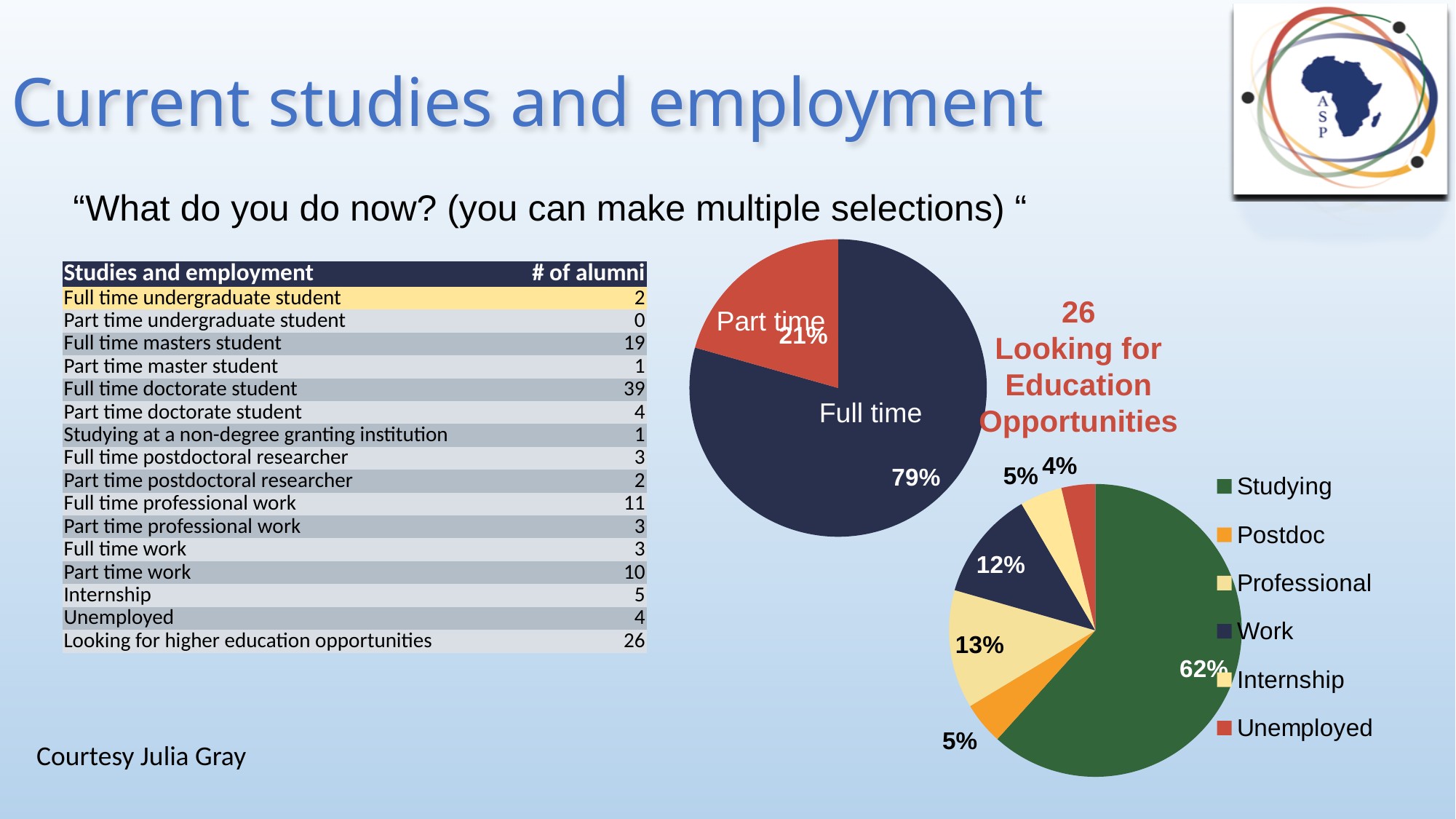
In the upper pie chart showing Full time and Part time, what share is Part time? 21% In the lower pie chart, what share is Work? 12% In the lower pie chart, which category has the largest share? Studying What kind of chart is the lower chart with the legend Studying, Postdoc, Professional, Work, Internship and Unemployed? pie chart In the lower pie chart, which category has the smallest share? Unemployed In the lower pie chart, what share is Studying? 62% In the lower pie chart, what share is Professional? 13% In the lower pie chart, what colour is the Studying slice? green How many categories does the legend of the lower pie chart list? 6 In the upper pie chart showing Full time and Part time, what is the difference in percentage points between Full time and Part time? 58 In the upper pie chart showing Full time and Part time, which slice is larger, Full time or Part time? Full time In the upper pie chart showing Full time and Part time, what share is Full time? 79%